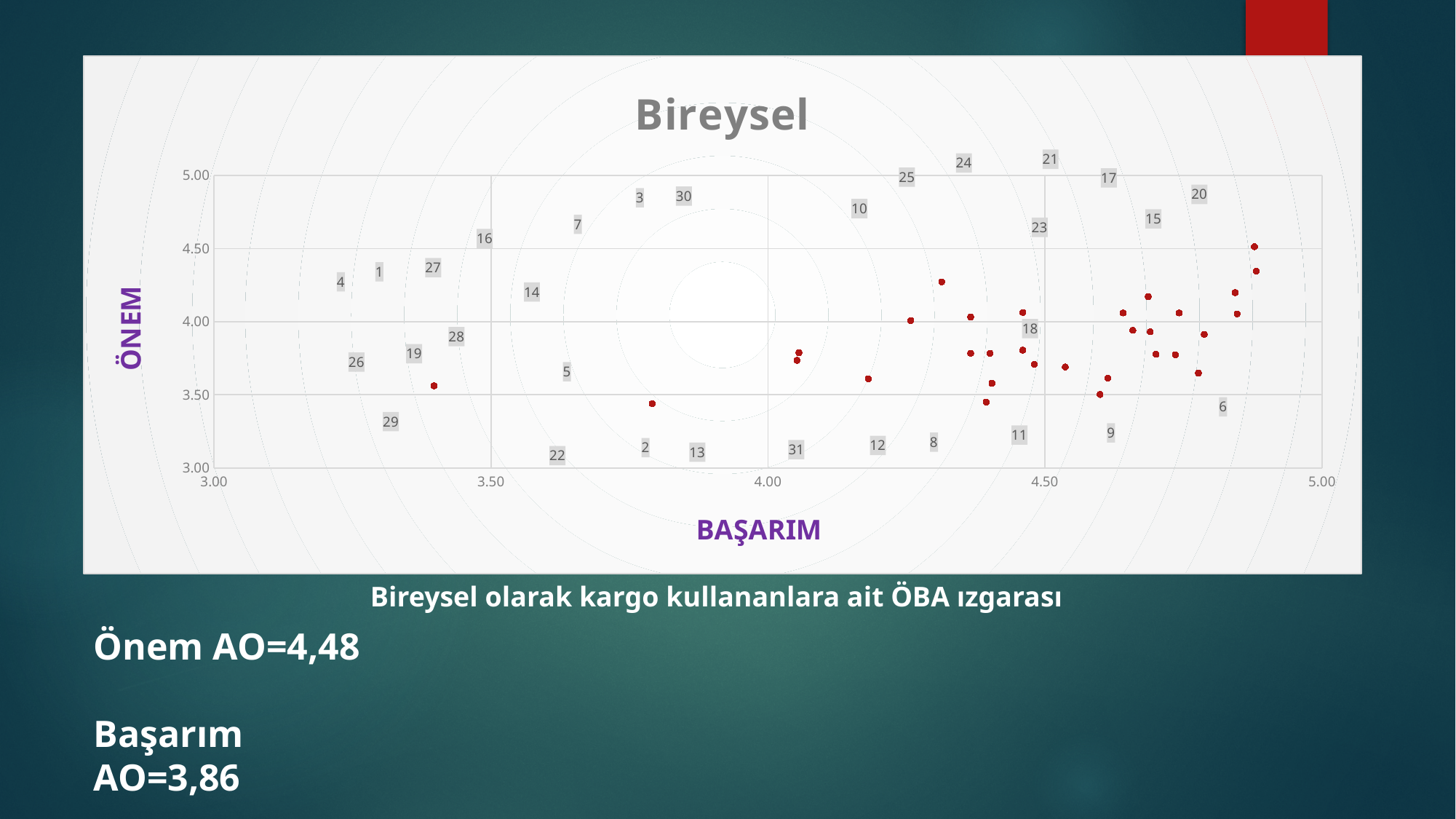
What are the titles of the x axis and the y axis of the chart? BAŞARIM (x axis) and ÖNEM (y axis) Do most of the data points lie to the right of 4.00 on the BAŞARIM axis or to the left of it? To the right What kind of chart is shown on the slide? Scatter chart What is the title of the chart? Bireysel Is the ÖNEM value of the lowest data point greater or less than 3.50? less Is the BAŞARIM value of the leftmost data point greater or less than 3.50? less Is the BAŞARIM value of the highest data point (the one with the largest ÖNEM) greater or less than 4.50? greater What is the lowest value shown on the BAŞARIM axis? 3.00 How many data points are plotted in the chart? 31 What is the highest value shown on the ÖNEM axis? 5.00